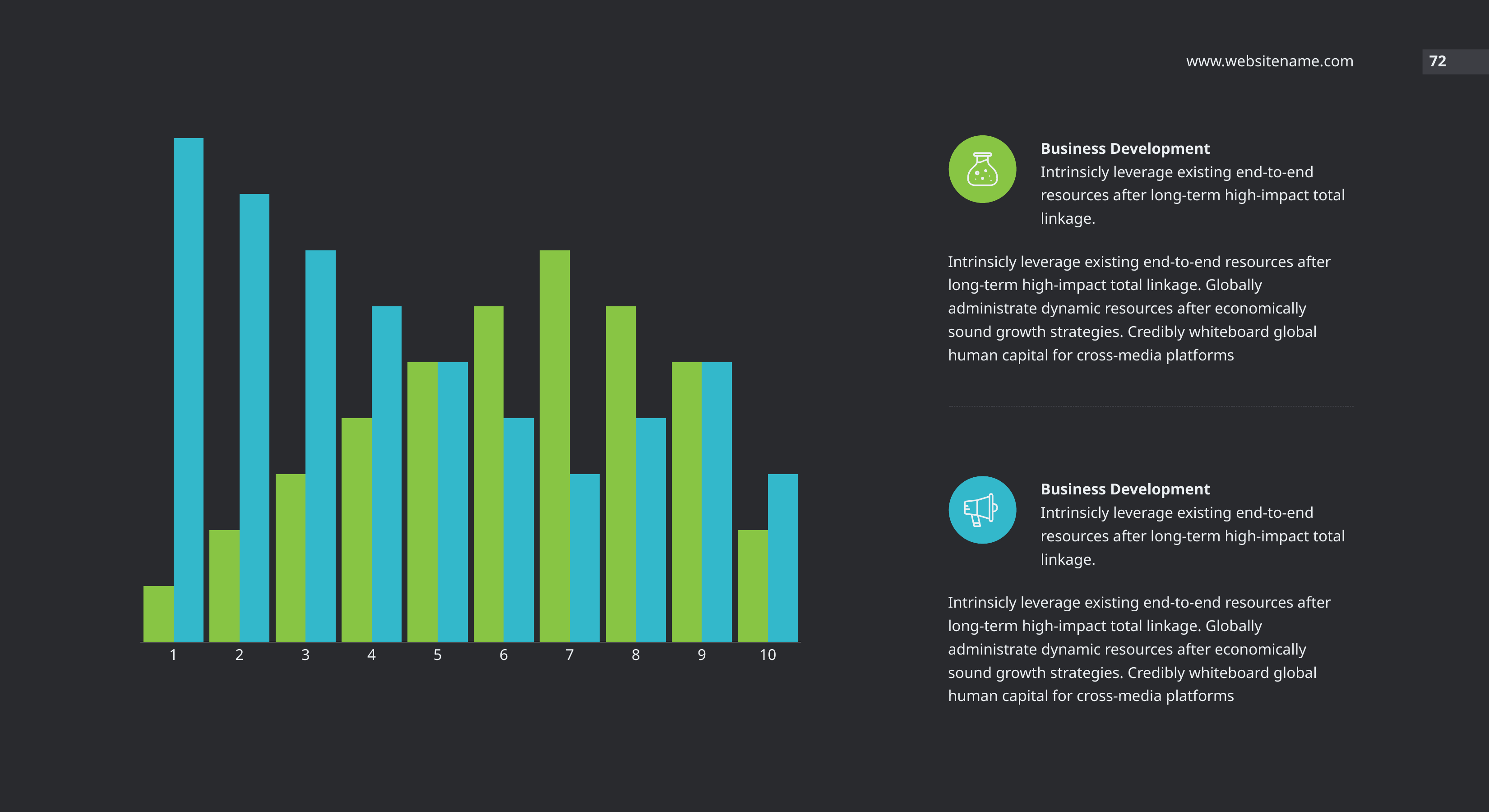
How many bars are plotted for each category in the chart? 2 What two colours are used for the bars in the chart? Green and blue Is the blue bar at category 1 taller or shorter than the blue bar at category 10? Taller At category 7, which bar is taller, the blue bar or the green bar? Green Which category has the tallest green bar? 7 How many categories are shown on the x axis of the chart? 10 Which category has the tallest blue bar? 1 What kind of chart is shown on the slide? Bar chart Do the green bars rise or fall from category 1 to category 7? Rise Do the blue bars rise or fall from category 1 to category 7? Fall Which category has the shortest green bar? 1 At category 2, which bar is taller, the blue bar or the green bar? Blue